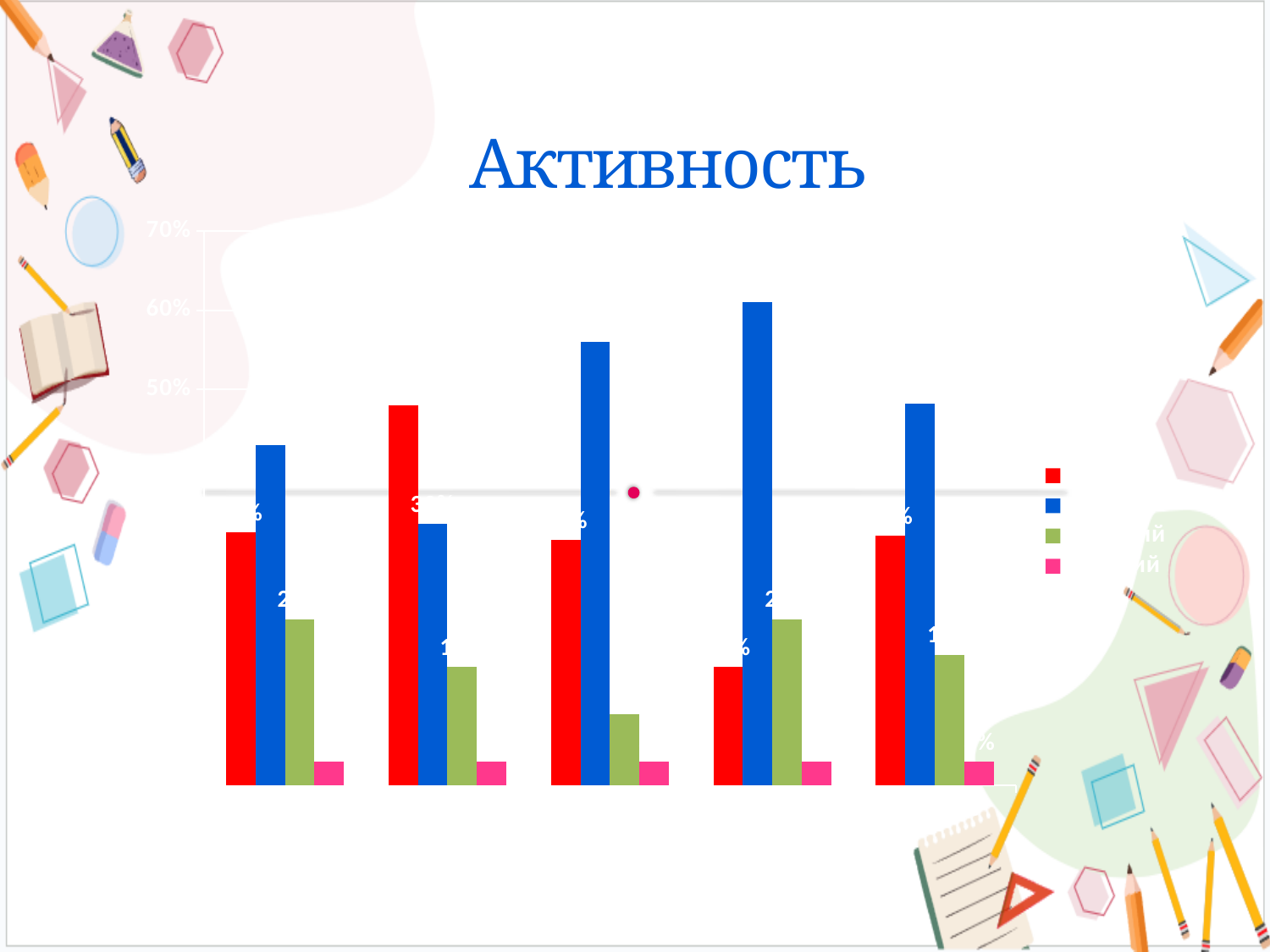
Which group of bars has the tallest blue bar? the fourth group from the left How many series does the legend list? 4 Is the blue bar in the third group from the left greater or less than 50%? greater Is the blue bar in the fourth group from the left greater or less than 70%? less Is the blue bar in the first group from the left greater or less than 50%? less What is the title of the chart? Активность What kind of chart is shown on the slide? bar chart In the second group from the left, which is taller, the red bar or the blue bar? the red bar Which group of bars has the tallest red bar? the second group from the left Which group of bars has the shortest red bar? the fourth group from the left How many groups of bars are plotted along the x axis? 5